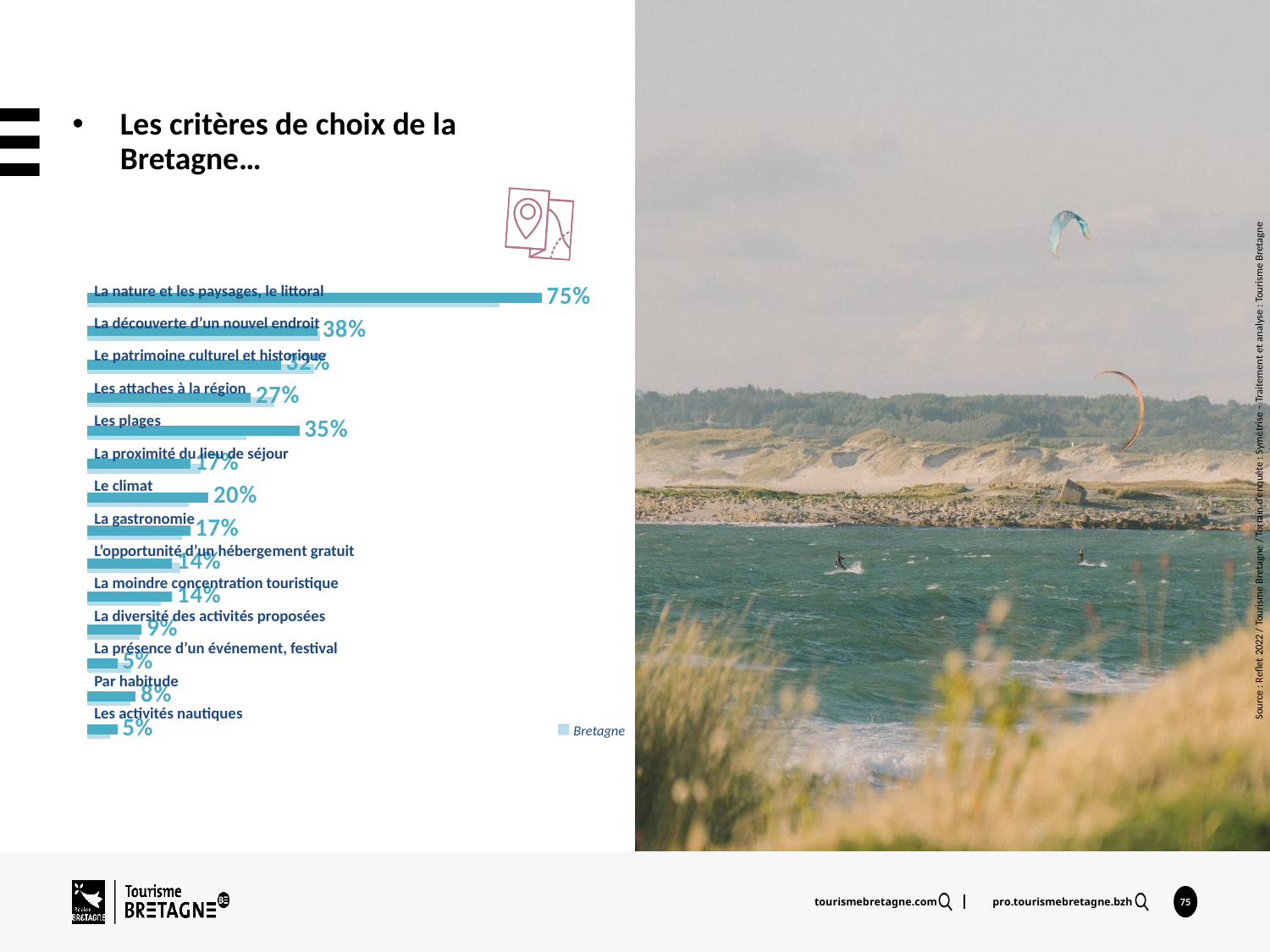
What is the value for "La nature et les paysages, le littoral"? 75% What is the value for "Le climat"? 20% Which category has the highest value? La nature et les paysages, le littoral What is the value for "Par habitude"? 8% What is the value for "La découverte d'un nouvel endroit"? 38% What is the difference between the values for "La nature et les paysages, le littoral" and "La découverte d'un nouvel endroit"? 37% What is the value for "Les plages"? 35% How many series does the legend list? 1 Which is larger, the value for "Les plages" or the value for "Le patrimoine culturel et historique"? Les plages How many categories are shown in the chart? 14 What series name appears in the chart legend? Bretagne What kind of chart is shown on the slide? bar chart